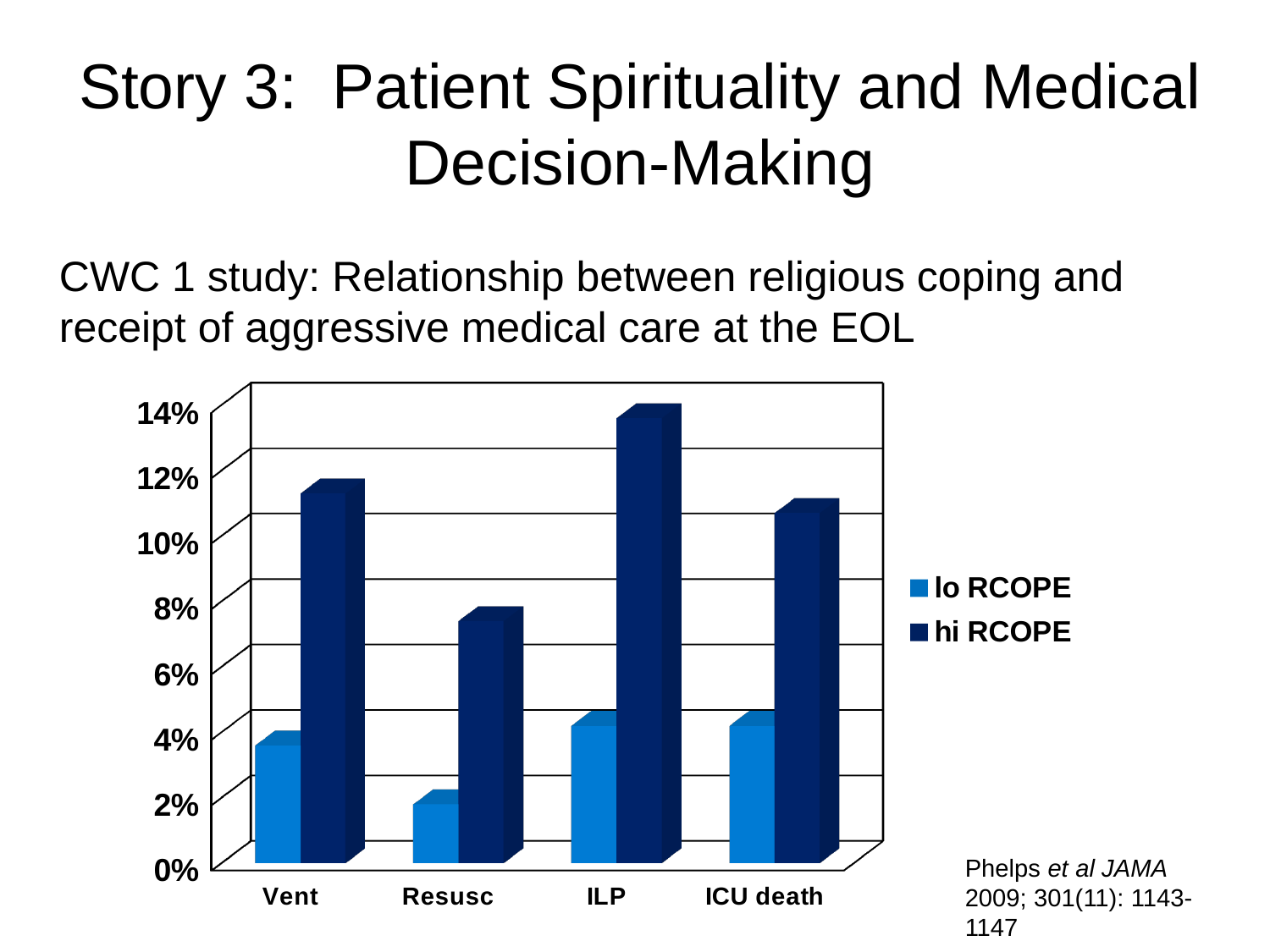
What are the two series named in the chart's legend? lo RCOPE and hi RCOPE Is the hi RCOPE value for Vent greater or less than 10%? greater Which is larger, the hi RCOPE value for Vent or the hi RCOPE value for Resusc? Vent Which category has the lowest lo RCOPE value? Resusc Which category has the lowest hi RCOPE value? Resusc Is the hi RCOPE value for Resusc greater or less than 10%? less How many series does the chart's legend list? 2 How many categories are shown on the x axis of the chart? 4 What kind of chart is shown on the slide? bar chart Is the hi RCOPE value for ILP greater or less than 12%? greater Which category has the highest hi RCOPE value? ILP